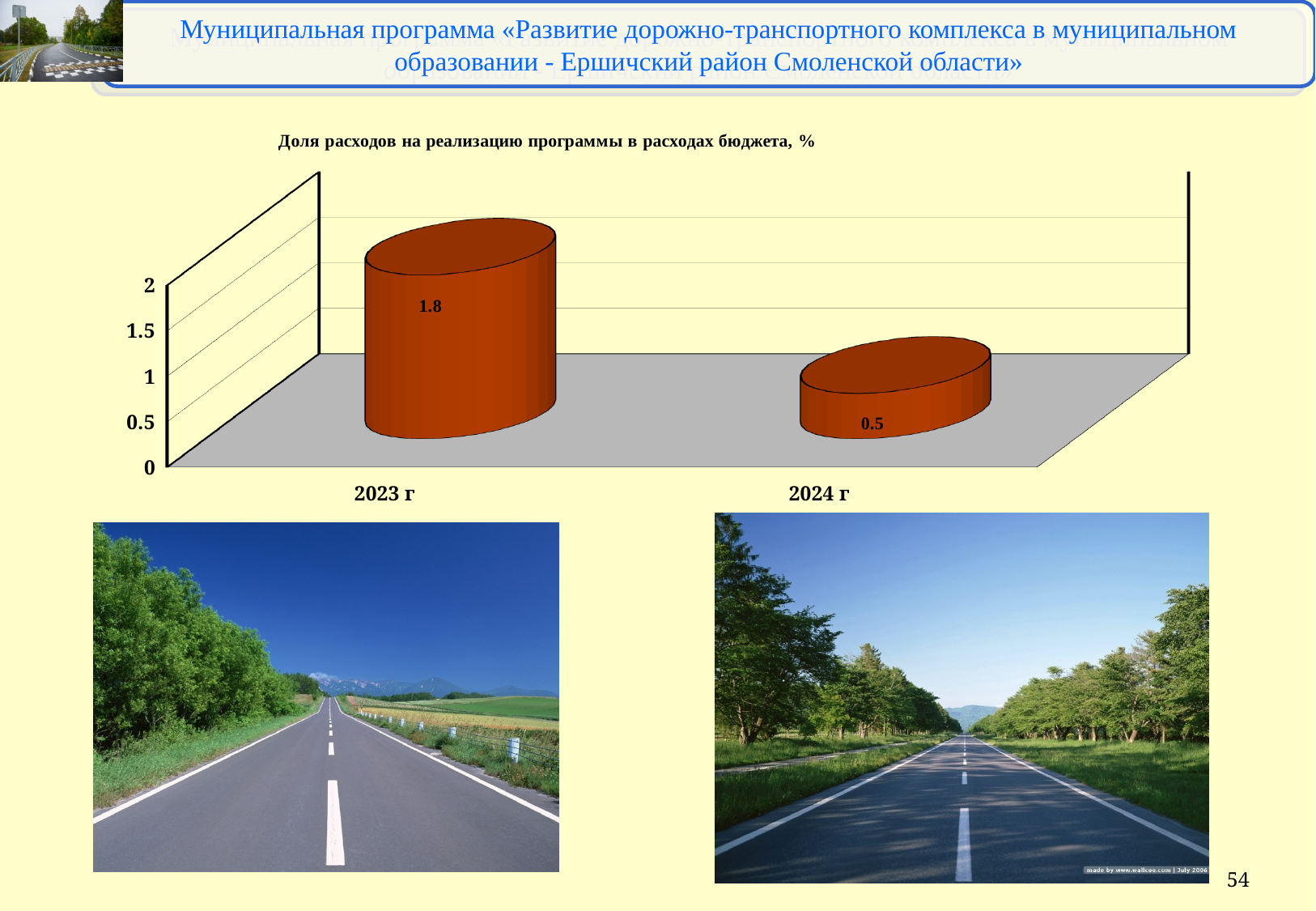
Which is larger, the value for 2023 г or for 2024 г? 2023 г Do the values rise or fall from 2023 г to 2024 г? fall What is the value for 2023 г? 1.8 What is the title of the chart? Доля расходов на реализацию программы в расходах бюджета, % How many categories are shown on the chart? 2 What is the value for 2024 г? 0.5 Which year has the lowest value? 2024 г Is the value for 2024 г greater or less than 1? less Is the value for 2023 г greater or less than 1? greater What is the difference between the values for 2023 г and 2024 г? 1.3 Which year has the highest value? 2023 г What kind of chart is shown on the slide? bar chart